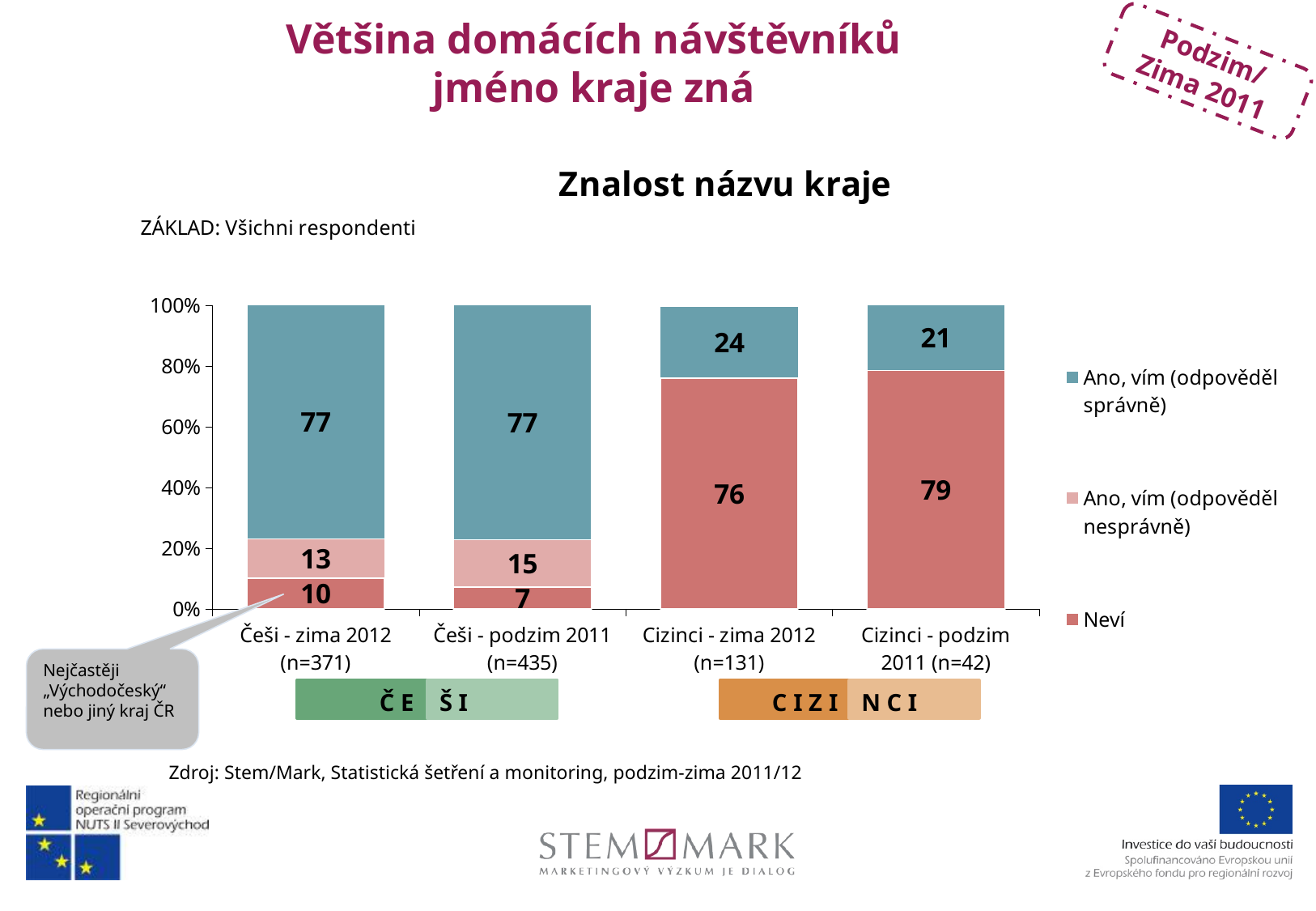
Which category has the highest value for "Neví"? Cizinci - podzim 2011 (n=42) What is the title of the chart? Znalost názvu kraje What is the value for "Neví" for Cizinci - podzim 2011 (n=42)? 79 What is the value for "Ano, vím (odpověděl nesprávně)" for Češi - podzim 2011 (n=435)? 15 Which is larger: the "Ano, vím (odpověděl správně)" value for Cizinci - zima 2012 (n=131) or for Cizinci - podzim 2011 (n=42)? Cizinci - zima 2012 (n=131) How many categories are shown on the x axis of the chart? 4 What is the value for "Neví" for Češi - podzim 2011 (n=435)? 7 What is the difference between the "Neví" values for Cizinci - zima 2012 (n=131) and Češi - zima 2012 (n=371)? 66 What is the value for "Ano, vím (odpověděl správně)" for Češi - zima 2012 (n=371)? 77 What kind of chart is shown on the slide? stacked bar chart How many series does the legend list? 3 Which category has the lowest value for "Ano, vím (odpověděl správně)"? Cizinci - podzim 2011 (n=42)